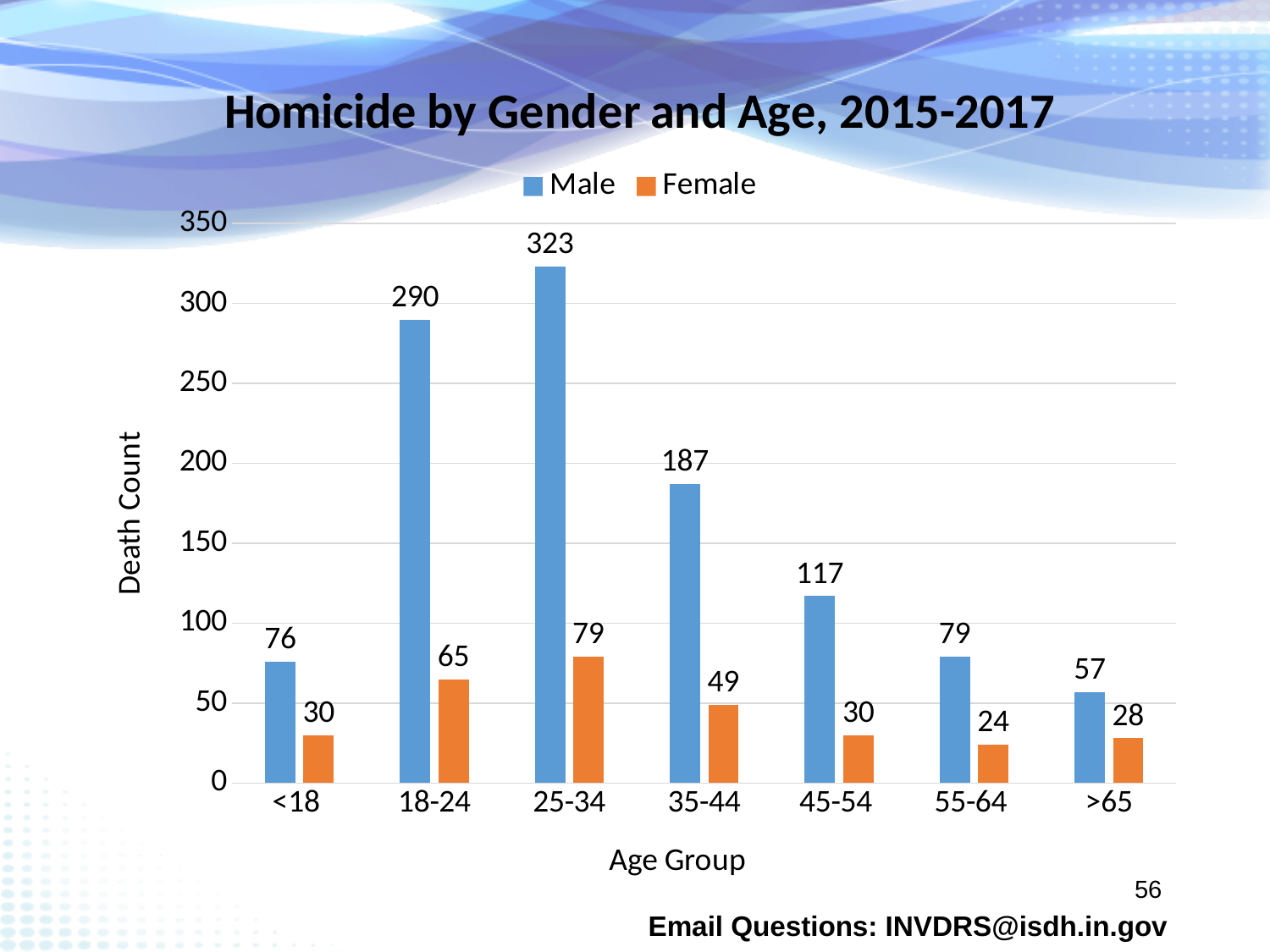
Do the Male death counts rise or fall from the 25-34 age group to the >65 age group? fall What is the title of the chart? Homicide by Gender and Age, 2015-2017 How many series does the legend list? 2 Which age group has the lowest Female death count? 55-64 Which is larger, the Male death count for 45-54 or the Male death count for 55-64? 45-54 How many age groups are shown on the x axis? 7 What is the difference between the Male and Female death counts for the 35-44 age group? 138 What is the Female death count for the 18-24 age group? 65 What kind of chart is shown on the slide? bar chart Which age group has the highest Male death count? 25-34 What is the Male death count for the 25-34 age group? 323 Is the Male death count for the 18-24 age group greater or less than 250? greater